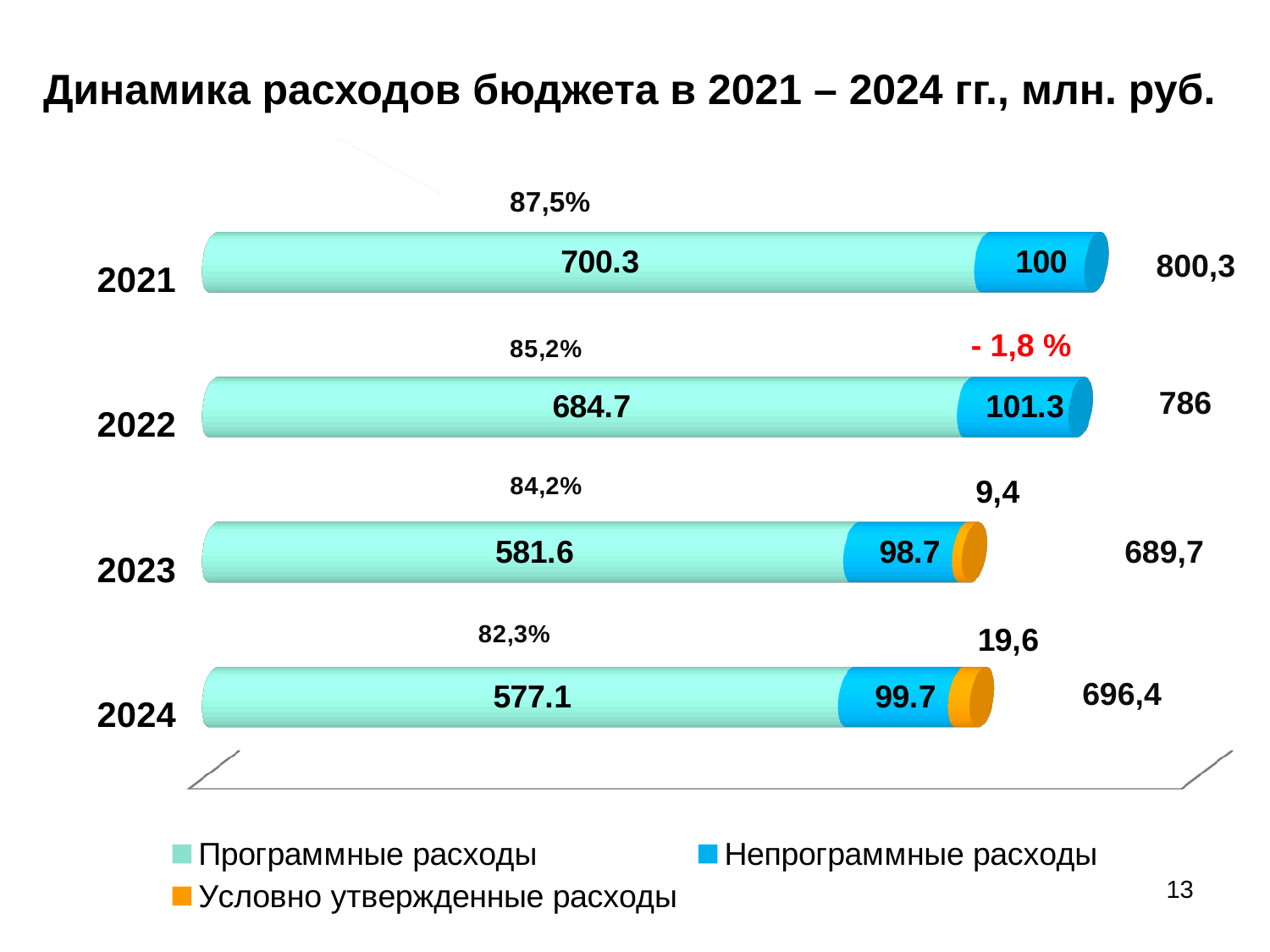
What is the value of Программные расходы for 2021? 700.3 What is the value of Условно утвержденные расходы for 2024? 19,6 Which year has the lowest value of Программные расходы? 2024 How many series does the legend list? 3 Is Непрограммные расходы larger in 2022 or in 2023? 2022 What is the value of Непрограммные расходы for 2022? 101.3 What kind of chart is shown on the slide? Stacked bar chart What percentage label is shown above the 2024 bar? 82,3% How many years are shown on the chart? 4 Which year has the highest value of Программные расходы? 2021 What is the total shown for the 2023 bar? 689,7 What is the difference between Программные расходы in 2021 and 2022? 15.6